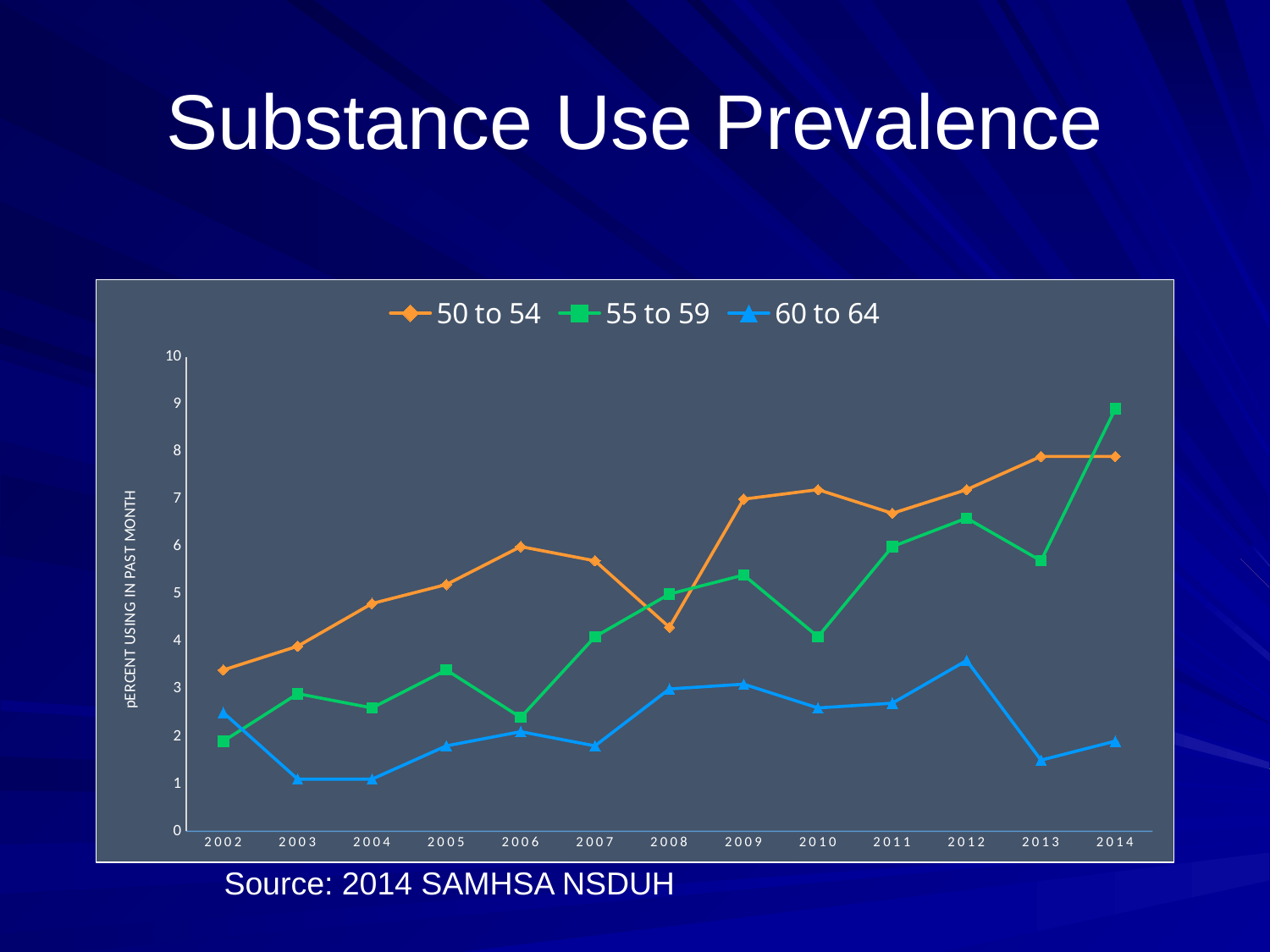
Which age group is shown with the green line? 55 to 59 Is the value for 55 to 59 in 2014 greater or less than 8? greater How many years are plotted along the x axis? 13 How many series does the legend list? 3 What is the title of the y axis? pERCENT USING IN PAST MONTH Is the value for 50 to 54 in 2009 greater or less than 6? greater Is the value for 60 to 64 in 2003 greater or less than 2? less What kind of chart is shown on the slide? line chart Which age group has the highest value in 2014? 55 to 59 In which year does the 55 to 59 series reach its highest value? 2014 In 2008, which is higher: 50 to 54 or 55 to 59? 55 to 59